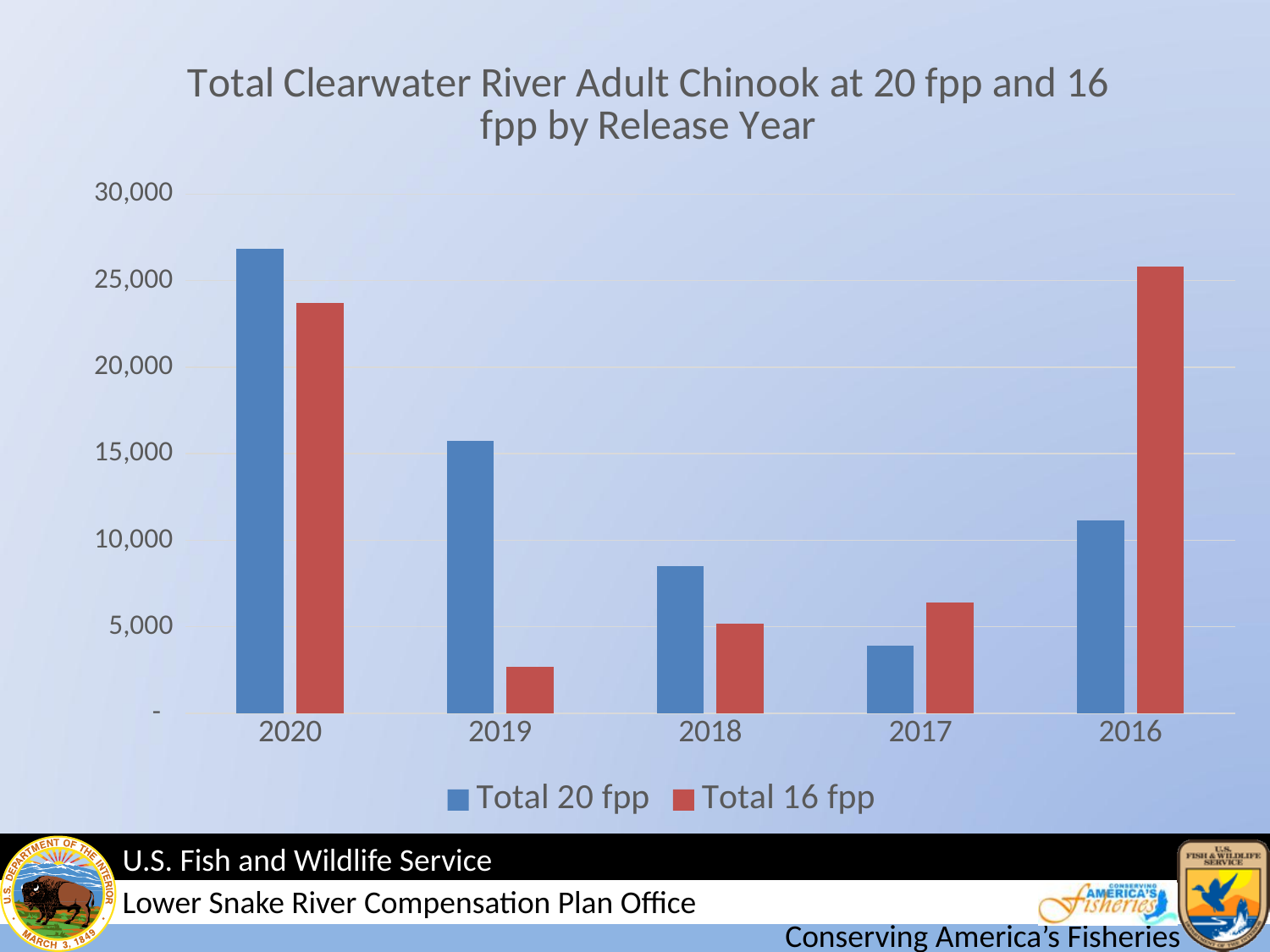
Is the Total 20 fpp value for 2020 greater or less than 25,000? greater How many series does the legend list? 2 Which release year has the lowest Total 20 fpp value? 2017 How many release years are shown on the x axis? 5 Which release year has the highest Total 16 fpp value? 2016 Is the Total 16 fpp value for 2019 greater or less than 5,000? less What kind of chart is shown on the slide? Bar chart Which release year has the highest Total 20 fpp value? 2020 For release year 2019, which is larger: Total 20 fpp or Total 16 fpp? Total 20 fpp For release year 2017, which is larger: Total 20 fpp or Total 16 fpp? Total 16 fpp Which release year has the lowest Total 16 fpp value? 2019 Is the Total 16 fpp value for 2016 greater or less than 20,000? greater